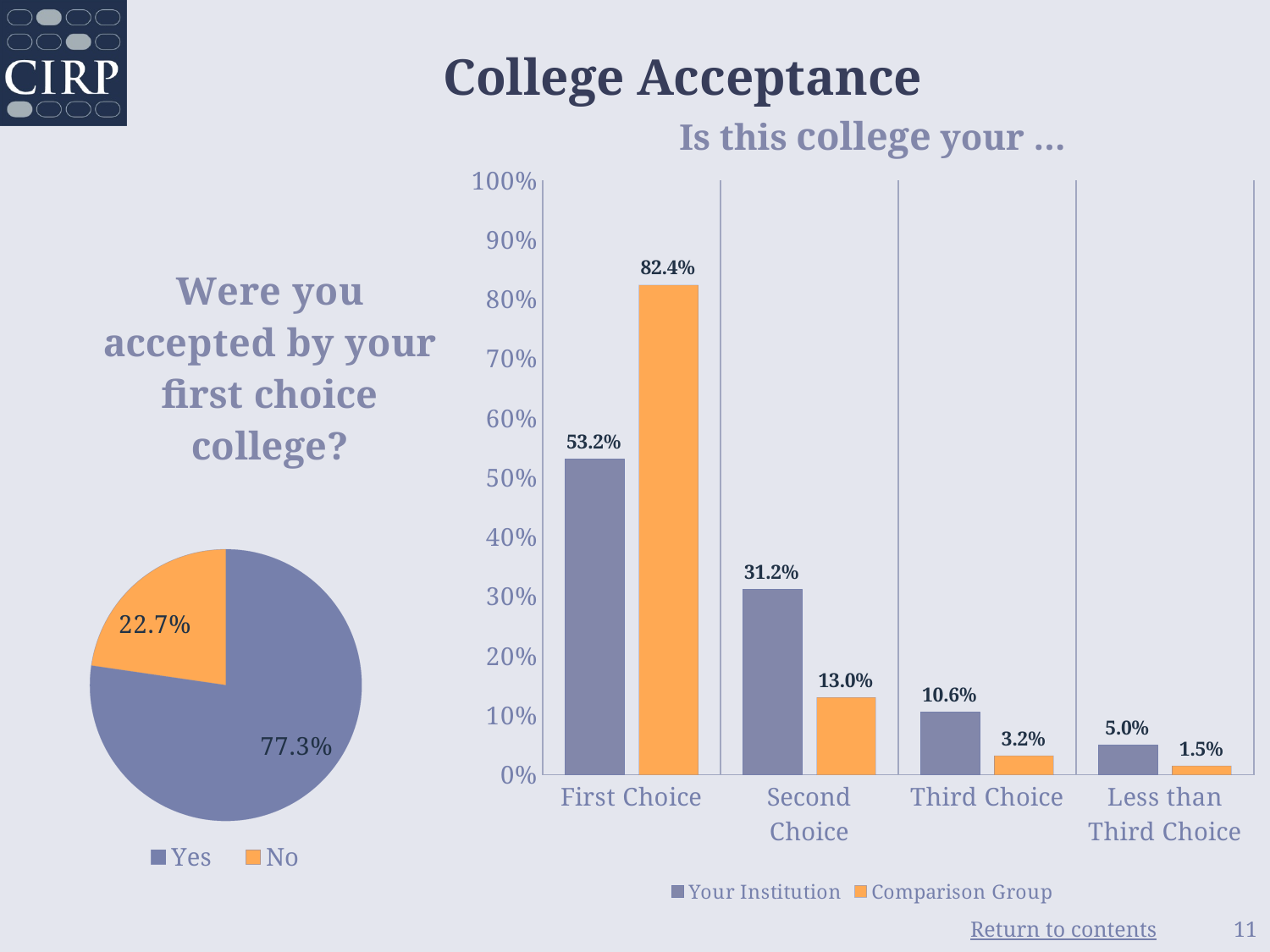
In the pie chart 'Were you accepted by your first choice college?', what share of the pie is Yes? 77.3% In the bar chart 'Is this college your ...', what is the value for Comparison Group for Second Choice? 13.0% In the bar chart 'Is this college your ...', what is the difference between Comparison Group and Your Institution for First Choice? 29.2% In the bar chart 'Is this college your ...', which category has the lowest value for Your Institution? Less than Third Choice In the bar chart 'Is this college your ...', what is the value for Your Institution for First Choice? 53.2% In the bar chart 'Is this college your ...', do the Your Institution values rise or fall from First Choice to Less than Third Choice? fall In the bar chart 'Is this college your ...', which category has the highest value for Comparison Group? First Choice In the bar chart 'Is this college your ...', how many categories are shown on the x axis? 4 In the pie chart 'Were you accepted by your first choice college?', what is the value for No? 22.7% In the bar chart 'Is this college your ...', how many series does the legend list? 2 What kind of chart is the chart on the left of the slide? pie chart In the bar chart 'Is this college your ...', which is larger for Third Choice: Your Institution or Comparison Group? Your Institution